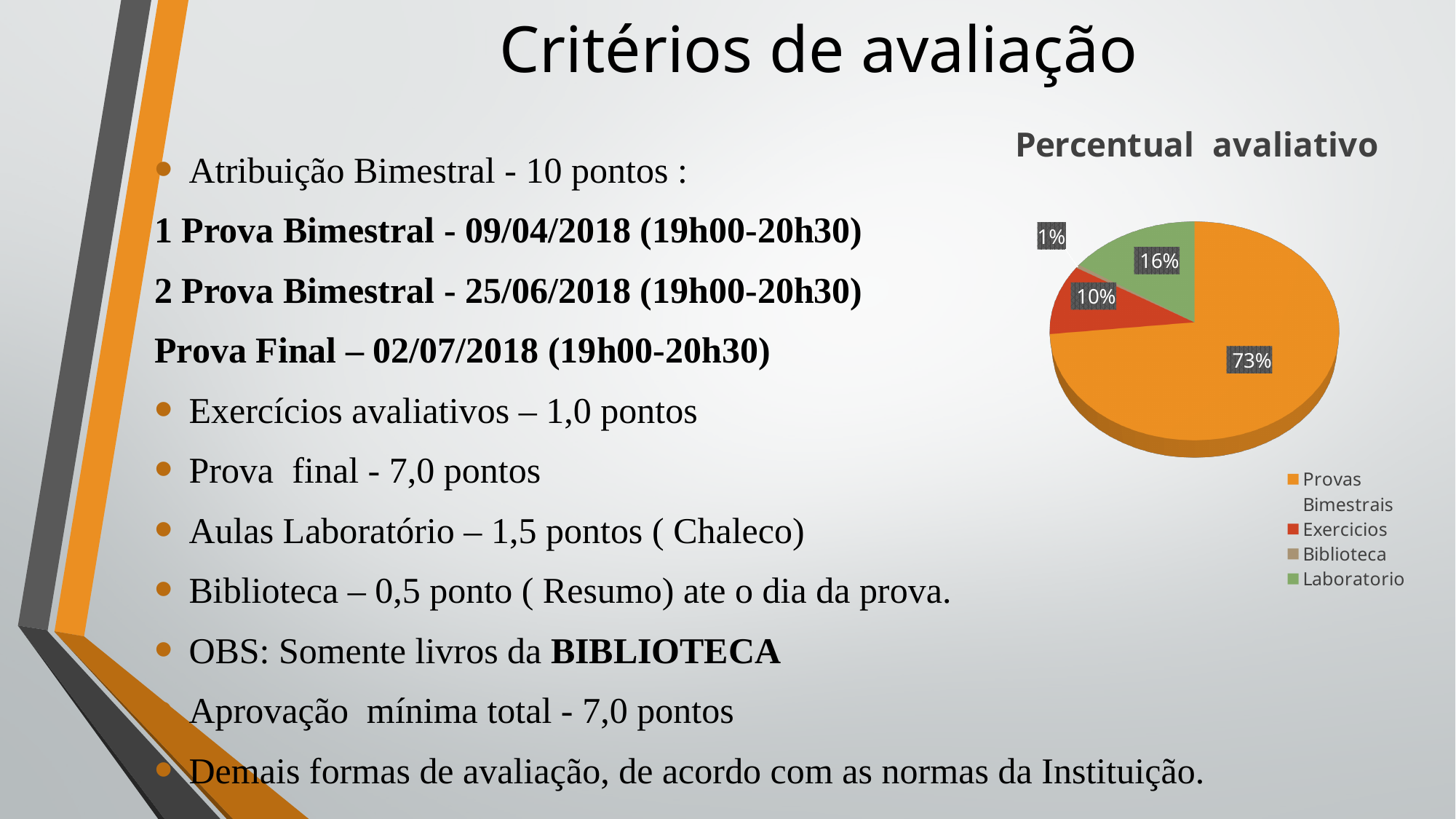
What colour is the Provas Bimestrais slice? orange What is the title of the chart? Percentual avaliativo Which is larger, the slice for Laboratorio or the slice for Exercicios? Laboratorio Which category has the smallest slice of the pie? Biblioteca How many categories does the legend list? 4 What percentage of the pie does Provas Bimestrais represent? 73% What is the difference in percentage points between Provas Bimestrais and Laboratorio? 57 Which category has the largest slice of the pie? Provas Bimestrais What kind of chart is shown on the slide? pie chart What percentage of the pie does Exercicios represent? 10% What percentage of the pie does Biblioteca represent? 1% What percentage of the pie does Laboratorio represent? 16%